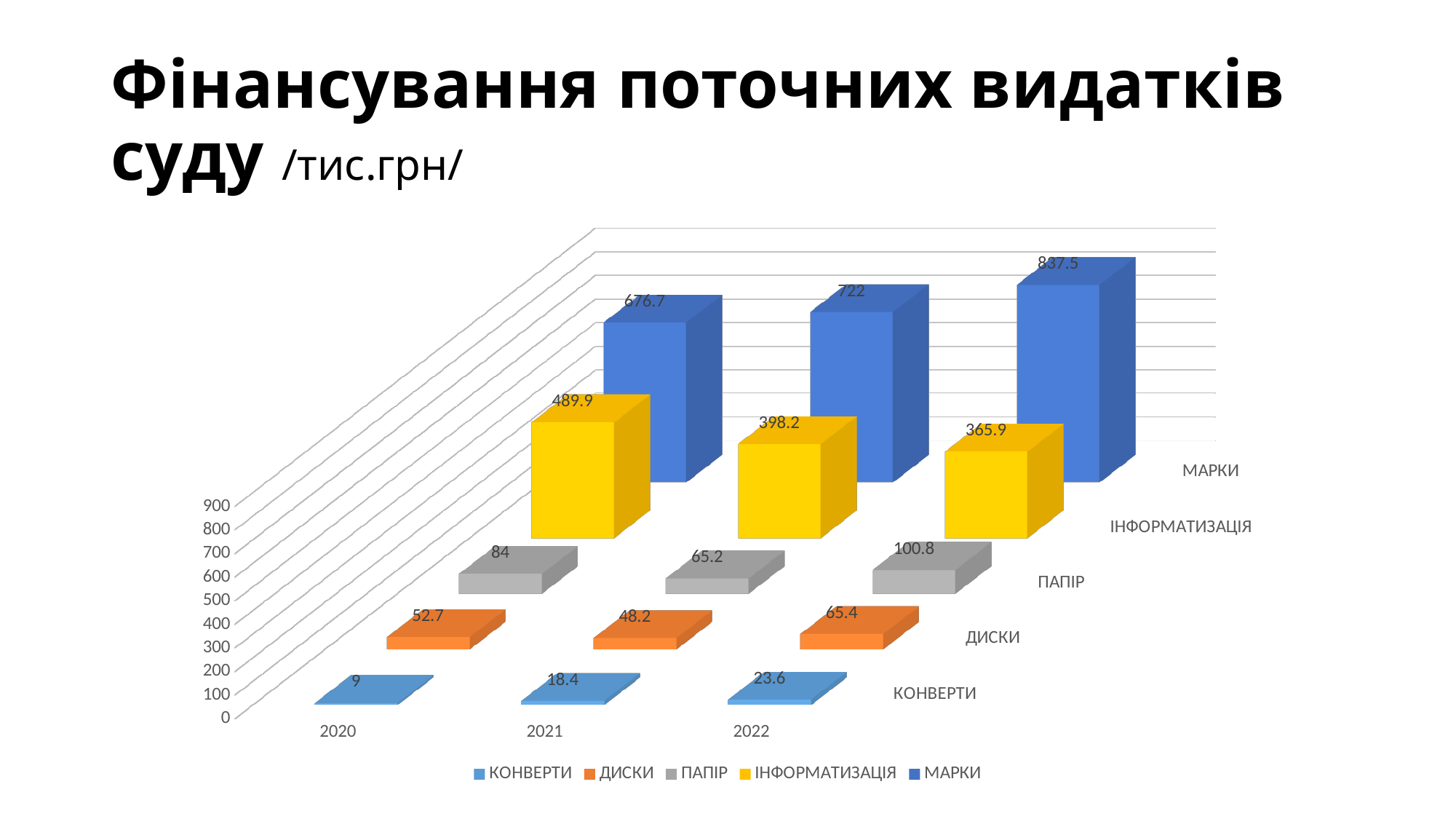
What is the value for ПАПІР in 2021? 65.2 What is the value for МАРКИ in 2022? 837.5 How many series does the legend list? 5 In which year is the value for МАРКИ highest? 2022 Do the values for КОНВЕРТИ rise or fall from 2020 to 2022? rise In which year is the value for ІНФОРМАТИЗАЦІЯ lowest? 2022 What is the difference between the МАРКИ values for 2022 and 2021? 115.5 What kind of chart is shown on the slide? bar chart What is the value for ІНФОРМАТИЗАЦІЯ in 2020? 489.9 How many years are shown on the x axis? 3 What is the value for КОНВЕРТИ in 2020? 9 Which is larger, the ДИСКИ value for 2020 or for 2021? 2020